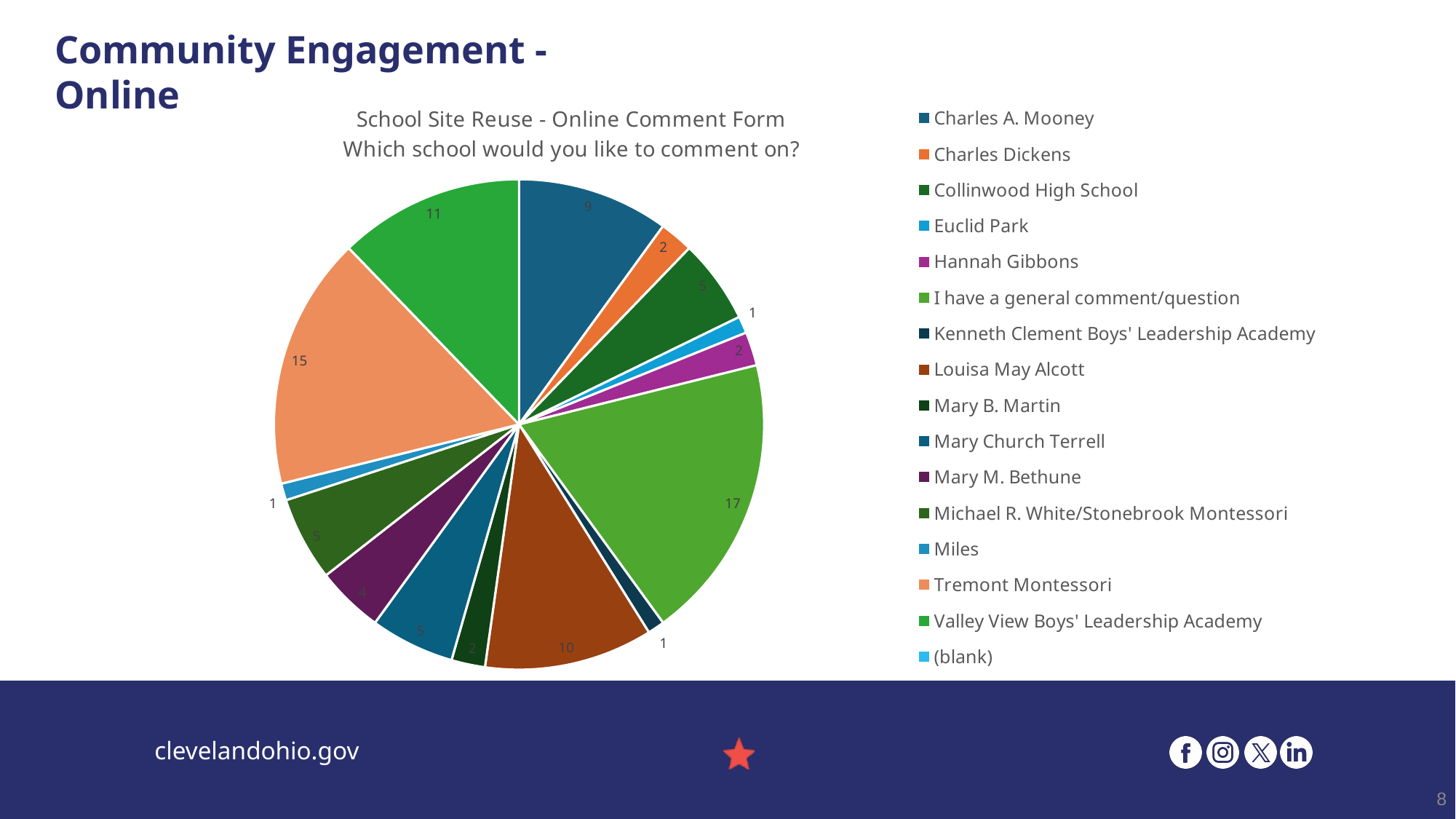
Which is larger, the value for Louisa May Alcott or the value for Charles A. Mooney? Louisa May Alcott What is the value for Louisa May Alcott? 10 What is the value for Mary M. Bethune? 4 How many entries does the chart legend list? 16 What is the difference between the values for Tremont Montessori and Valley View Boys' Leadership Academy? 4 What is the value for Tremont Montessori? 15 What is the value for 'I have a general comment/question'? 17 What type of chart is shown on the slide? Pie chart Which category has the largest slice of the pie? I have a general comment/question What is the value for Charles A. Mooney? 9 What is the title of the chart? School Site Reuse - Online Comment Form Which school would you like to comment on? What is the value for Valley View Boys' Leadership Academy? 11